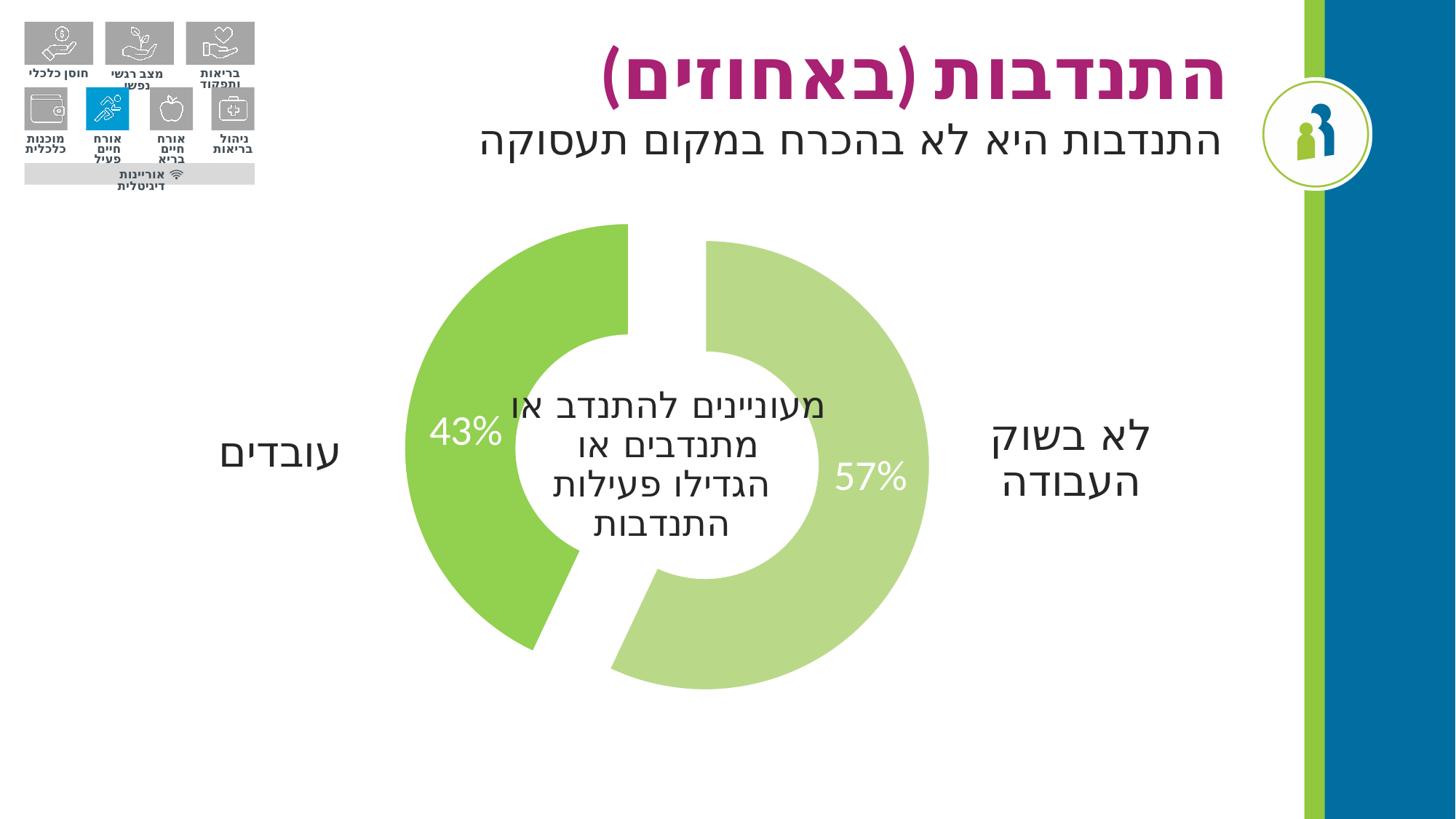
How many segments does the donut chart have? 2 What percentage is shown for the segment labeled "עובדים"? 43% Which is larger: the share for "עובדים" or the share for "לא בשוק העבודה"? לא בשוק העבודה Which segment of the donut chart is the smallest? עובדים What kind of chart is shown on the slide? Donut (pie) chart What share of the donut does the "עובדים" segment represent? 43% What is the difference in percentage points between the "לא בשוק העבודה" segment and the "עובדים" segment? 14 What text appears in the center of the donut chart? מעוניינים להתנדב או מתנדבים או הגדילו פעילות התנדבות What is the title of the slide containing the chart? התנדבות (באחוזים) What do the two segments of the donut chart add up to? 100% Which segment of the donut chart is the largest? לא בשוק העבודה What percentage is shown for the segment labeled "לא בשוק העבודה"? 57%